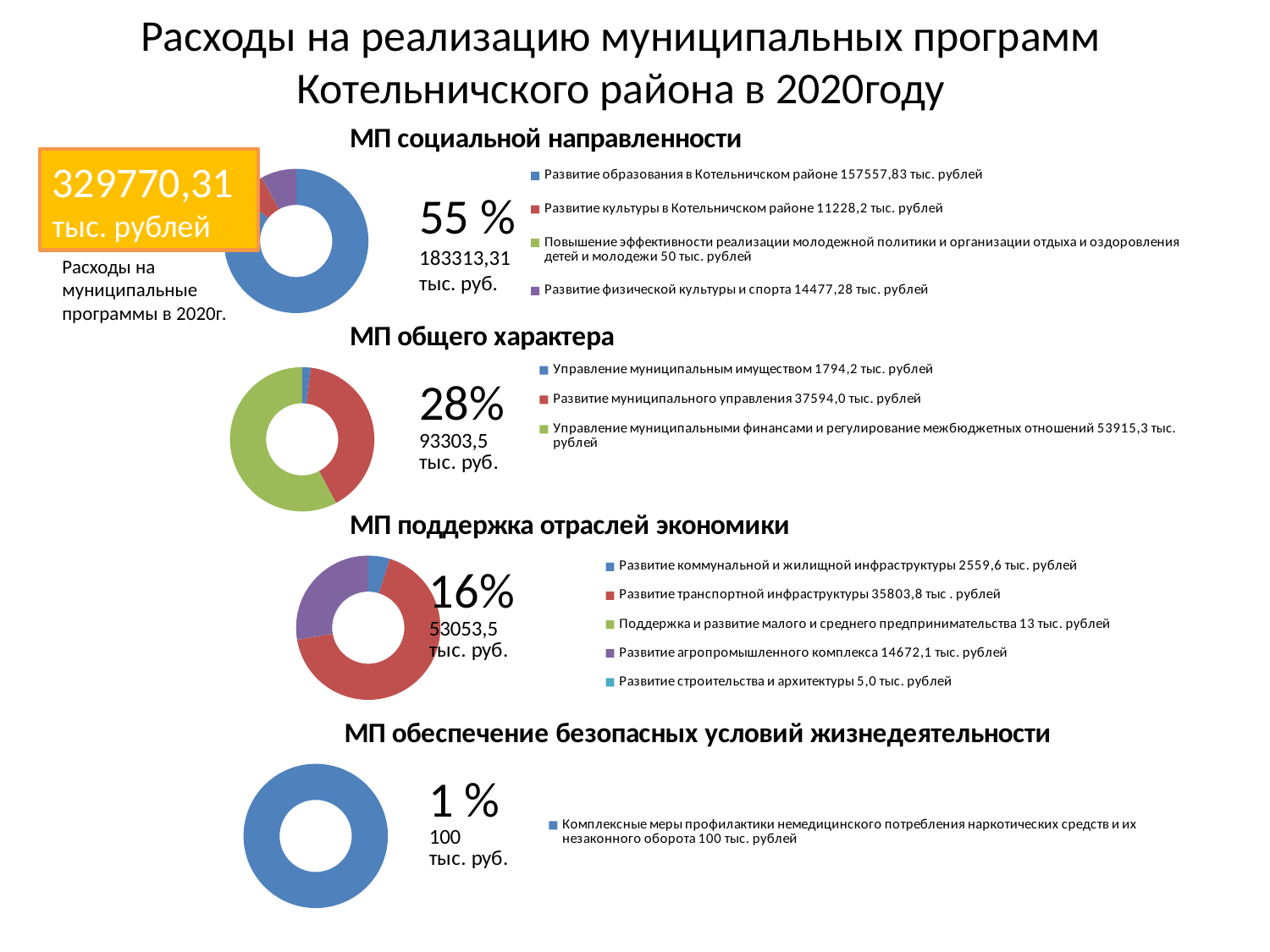
In the "МП поддержка отраслей экономики" chart, what is the difference between "Развитие агропромышленного комплекса" (14672,1) and "Развитие коммунальной и жилищной инфраструктуры" (2559,6)? 12112,5 тыс. рублей What share of total expenditure does "МП социальной направленности" account for, according to the slide? 55 % What is the total shown for "МП общего характера"? 93303,5 тыс. руб. In the "МП поддержка отраслей экономики" chart, which is larger: "Развитие транспортной инфраструктуры" or "Развитие агропромышленного комплекса"? Развитие транспортной инфраструктуры In the "МП общего характера" chart, what is the value for "Развитие муниципального управления"? 37594,0 тыс. рублей In the "МП общего характера" chart, which category has the largest value? Управление муниципальными финансами и регулирование межбюджетных отношений In the "МП социальной направленности" chart, what is the value for "Развитие образования в Котельничском районе"? 157557,83 тыс. рублей In the "МП социальной направленности" chart, how many categories does the legend list? 4 What is the value shown for "МП обеспечение безопасных условий жизнедеятельности"? 100 тыс. руб. What kind of chart is used for "МП социальной направленности"? Doughnut (pie) chart In the "МП поддержка отраслей экономики" chart, how many categories does the legend list? 5 In the "МП социальной направленности" chart, which category has the smallest value? Повышение эффективности реализации молодежной политики и организации отдыха и оздоровления детей и молодежи